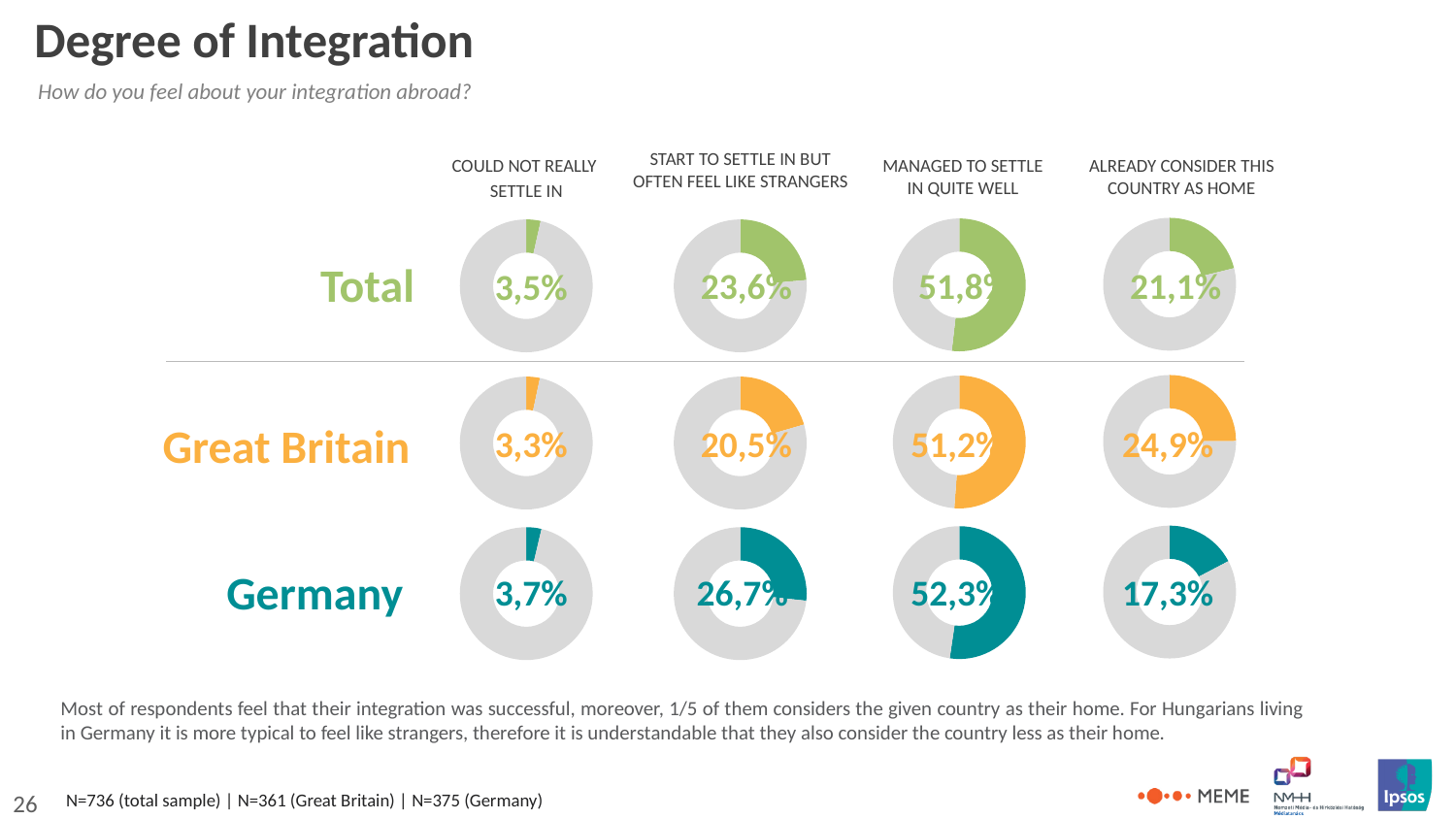
What type of chart is used to display the percentages on this slide? Donut (pie) chart What share of respondents in Germany 'already consider this country as home'? 17,3% Which integration category has the lowest share among Great Britain respondents? Could not really settle in What percentage of the Total sample say they 'managed to settle in quite well'? 51,8% How many donut charts are shown on the slide? 12 How many percentage points higher is the 'start to settle in but often feel like strangers' share for Germany than for Great Britain? 6,2 percentage points What percentage of Germany respondents 'could not really settle in'? 3,7% Which country has the higher share of respondents who 'already consider this country as home', Great Britain or Germany? Great Britain What is the difference between Great Britain's and Germany's shares for 'already consider this country as home'? 7,6 percentage points What percentage of Great Britain respondents 'start to settle in but often feel like strangers'? 20,5% What colour is used for the Germany row of charts? Teal Which of the four integration categories has the highest share for the Total sample? Managed to settle in quite well